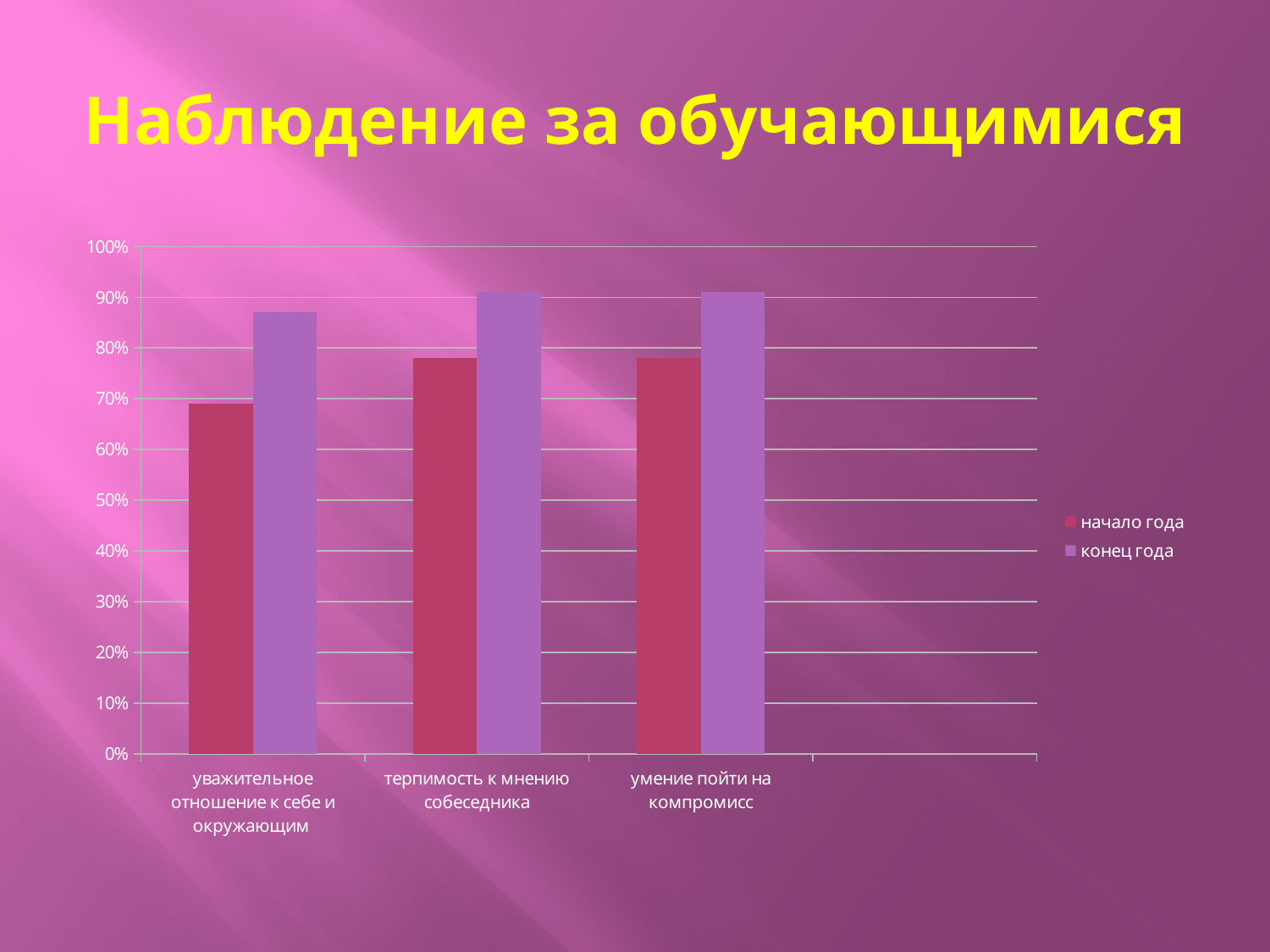
Is the value for начало года in the category умение пойти на компромисс greater or less than 70%? greater What is the title of the slide above the chart? Наблюдение за обучающимися How many series does the legend list? 2 How many categories are shown on the x axis? 3 Within the series конец года, which category has the lowest value? уважительное отношение к себе и окружающим Is the value for начало года in the category уважительное отношение к себе и окружающим greater or less than 60%? greater For the category уважительное отношение к себе и окружающим, which series has the larger value, начало года or конец года? конец года Is the value for конец года in the category уважительное отношение к себе и окружающим greater or less than 90%? less What are the two series named in the legend? начало года, конец года Within the series начало года, which category has the lowest value? уважительное отношение к себе и окружающим What kind of chart is shown on the slide? bar chart